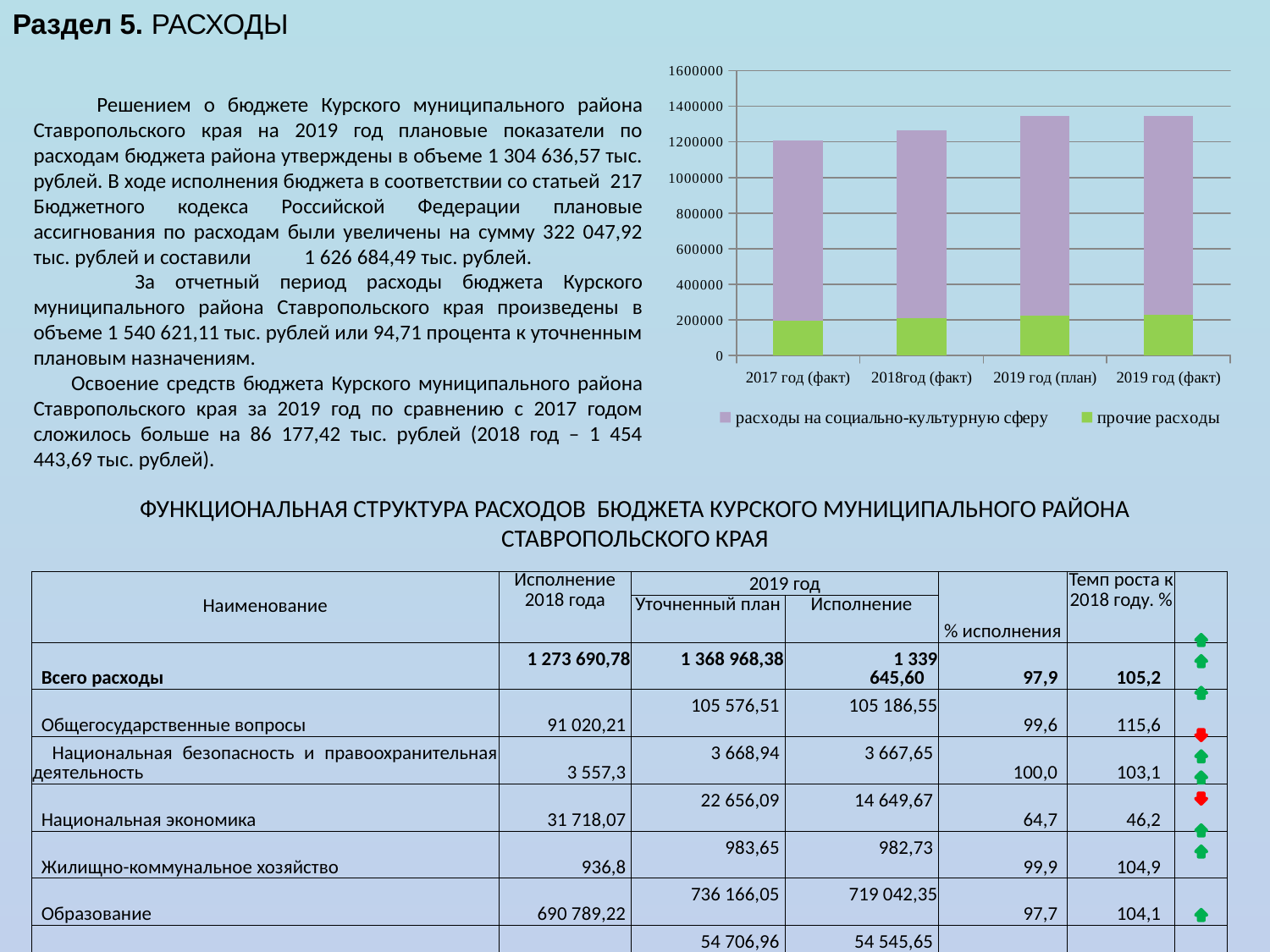
Do the total bar heights rise or fall from 2017 год (факт) to 2019 год (план)? rise What kind of chart is shown on the slide? stacked bar chart How many series does the chart legend list? 2 Is the value of прочие расходы for 2019 год (факт) greater or less than 200000? greater Is the total bar for 2017 год (факт) greater or less than 1000000? greater Which has the larger total bar: 2017 год (факт) or 2019 год (план)? 2019 год (план) Is the total bar for 2018год (факт) greater or less than 1200000? greater Which category has the lowest total bar height in the chart? 2017 год (факт) What is the first series listed in the chart legend? расходы на социально-культурную сферу Which series is shown in green in the chart? прочие расходы How many categories are shown on the x axis of the chart? 4